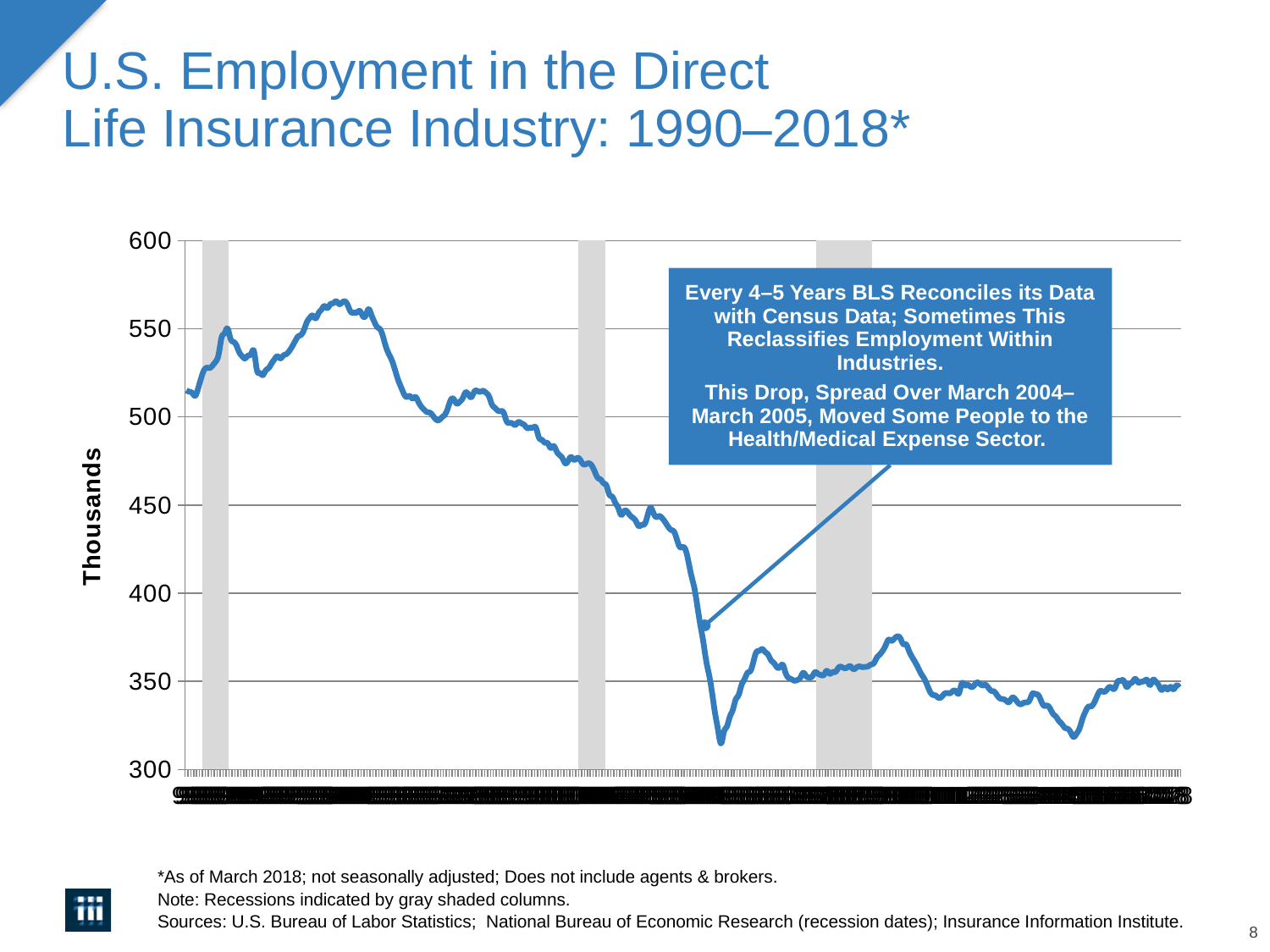
Overall, do the values rise or fall from the start of the series in 1990 to the end in 2018? fall Is the value at the start of the series (1990) greater or less than 500? greater Is the value at the point marked by the annotation arrow (the start of the March 2004–March 2005 drop) greater or less than 400? less Is the highest value reached on the chart greater or less than 550? greater What is the title of the vertical axis? Thousands According to the note, what do the gray shaded columns on the chart indicate? Recessions What kind of chart is shown on the slide? line chart